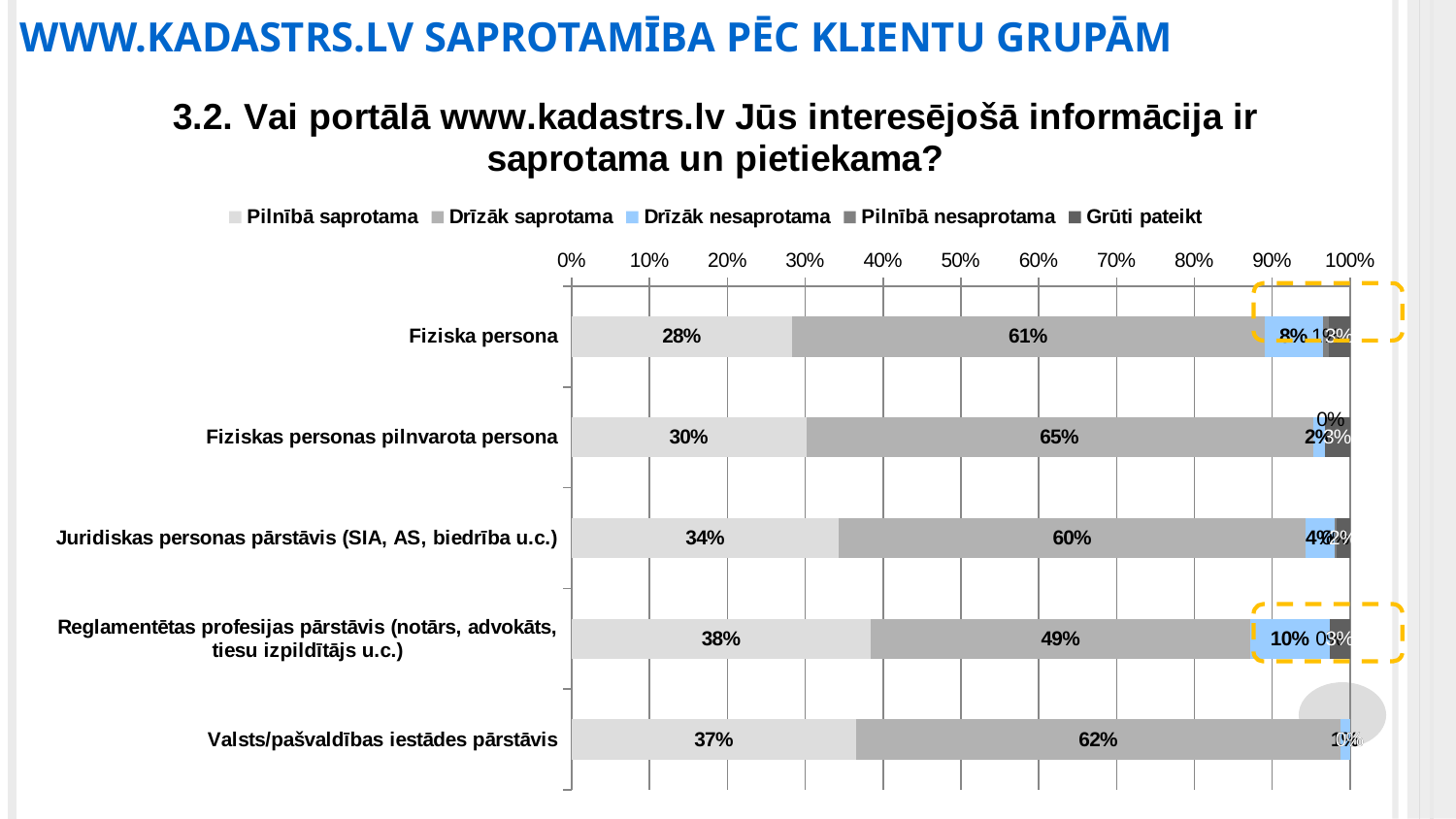
Which client group has the highest 'Pilnībā saprotama' value? Reglamentētas profesijas pārstāvis (notārs, advokāts, tiesu izpildītājs u.c.) What is the 'Pilnībā saprotama' value for 'Fiziska persona'? 28% What is the 'Drīzāk saprotama' value for 'Fiziskas personas pilnvarota persona'? 65% Which client group has the lowest 'Pilnībā saprotama' value? Fiziska persona Which client group has the lowest 'Drīzāk saprotama' value? Reglamentētas profesijas pārstāvis (notārs, advokāts, tiesu izpildītājs u.c.) What is the 'Drīzāk nesaprotama' value for 'Reglamentētas profesijas pārstāvis (notārs, advokāts, tiesu izpildītājs u.c.)'? 10% How many client groups (categories) are shown on the chart? 5 What is the 'Pilnībā saprotama' value for 'Reglamentētas profesijas pārstāvis (notārs, advokāts, tiesu izpildītājs u.c.)'? 38% How many series does the legend list? 5 What kind of chart is shown on the slide? Stacked bar chart Which is larger: the 'Pilnībā saprotama' value for 'Juridiskas personas pārstāvis (SIA, AS, biedrība u.c.)' or for 'Valsts/pašvaldības iestādes pārstāvis'? Valsts/pašvaldības iestādes pārstāvis What is the difference between the 'Drīzāk saprotama' values for 'Fiziskas personas pilnvarota persona' and 'Fiziska persona'? 4%